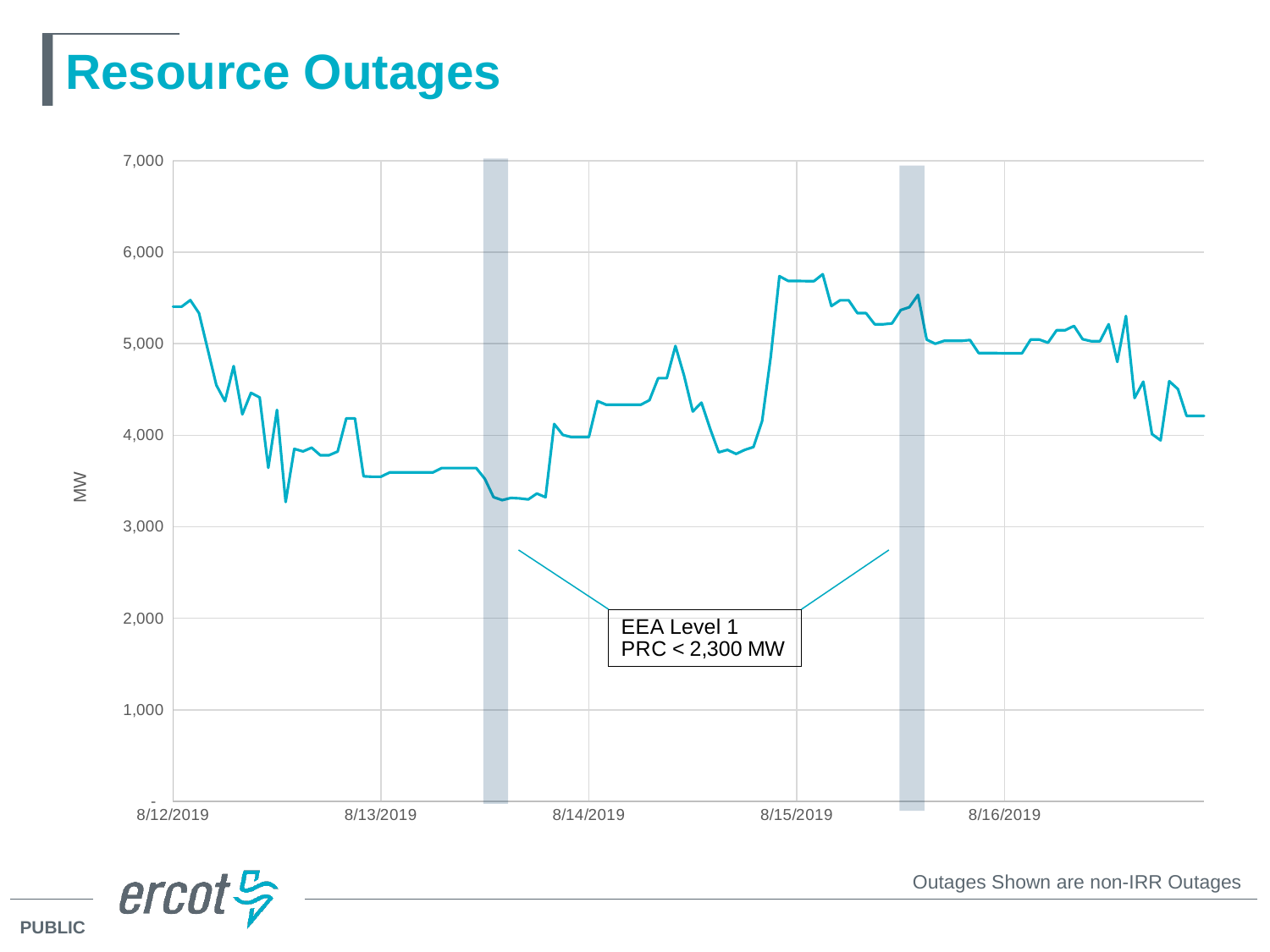
How many date labels are shown on the x axis? 5 Is the highest value reached by the line greater or less than 6,000? less Is the value at 8/12/2019 greater or less than 5,000? greater Is the value at 8/15/2019 greater or less than 5,000? greater What is the title of the chart? Resource Outages What kind of chart is shown on the slide? line chart Do the values generally rise or fall between 8/12/2019 and 8/13/2019? fall What is the label on the vertical axis of the chart? MW Near which x-axis date label does the line reach its highest value? 8/15/2019